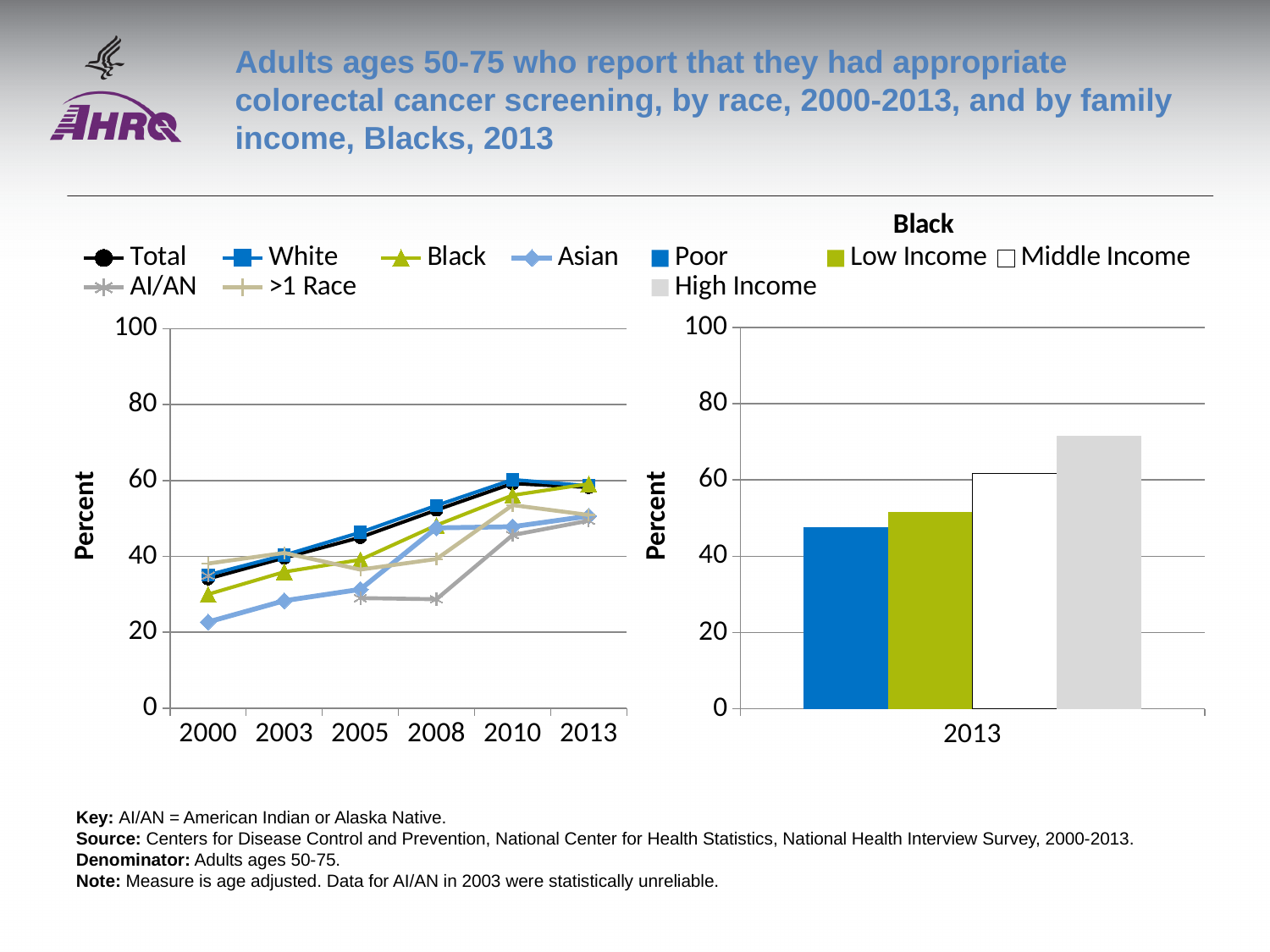
In the right chart titled "Black", which income group has the highest value in 2013? High Income In the left chart (by race), which group has the lowest value in 2000? Asian How many years are plotted on the x axis of the left chart (by race)? 6 In the right chart titled "Black", which income group has the lowest value in 2013? Poor What kind of chart is the right chart titled "Black"? bar chart In the right chart titled "Black", is the value for Poor greater or less than 60? less In the left chart (by race), is the value for Asian in 2000 greater or less than 40? less How many income groups does the legend of the right chart titled "Black" list? 4 In the left chart (by race), does the Total series rise or fall from 2000 to 2013? rise In the right chart titled "Black", is the value for High Income greater or less than 60? greater What kind of chart is the left chart showing screening by race, 2000-2013? line chart How many series does the legend of the left chart (by race) list? 6